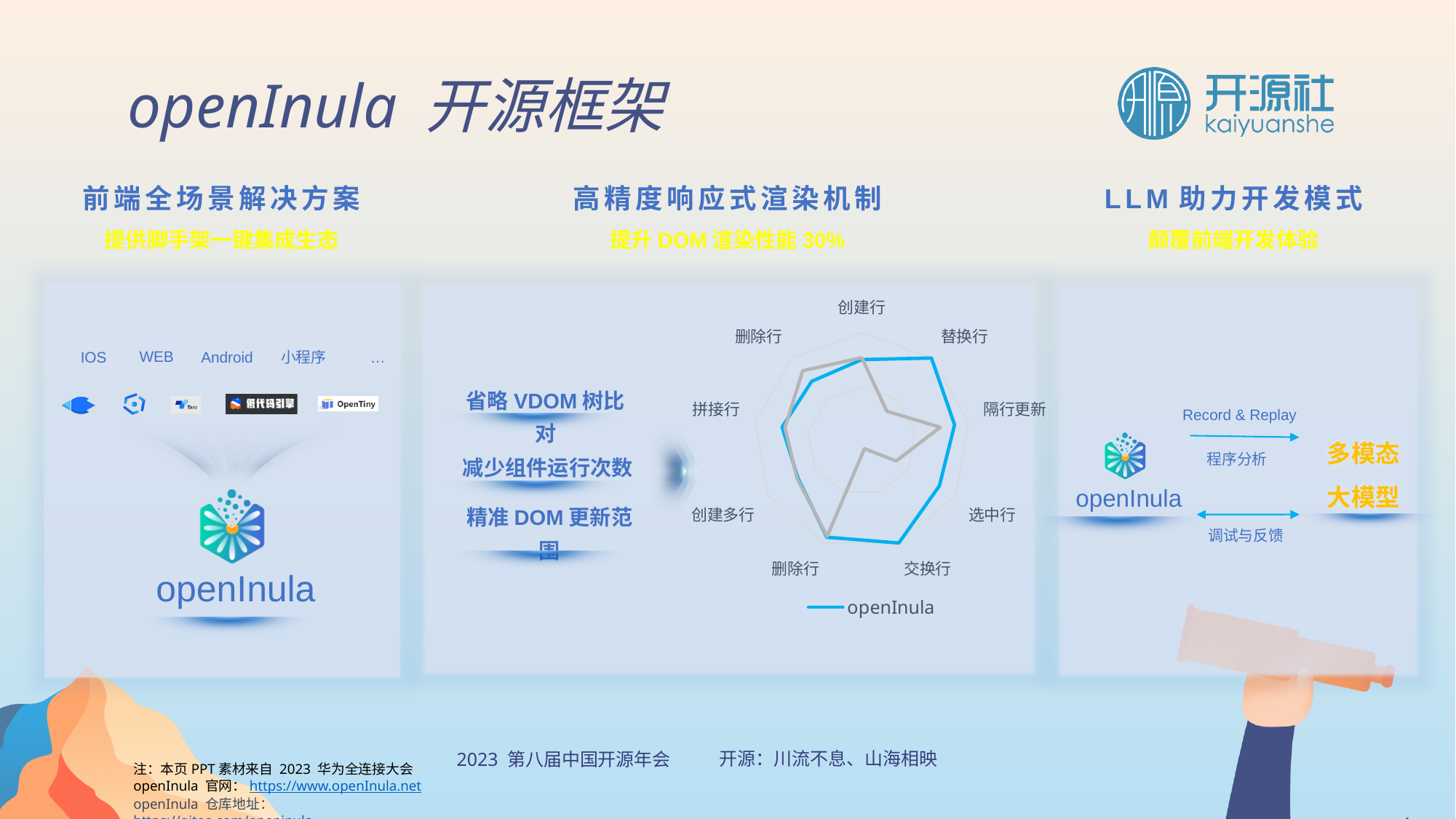
How many axes (categories) does the radar chart in the middle panel have? 9 What colour is the openInula series line in the radar chart? blue What kind of chart is shown in the middle panel under 高精度响应式渲染机制? radar chart How many series does the legend of the radar chart list? 1 Which category label appears at the top of the radar chart? 创建行 On the 替换行 axis of the radar chart, which line extends further from the centre, the blue openInula line or the grey line? openInula (blue) On the 选中行 axis of the radar chart, which line extends further from the centre, the blue openInula line or the grey line? openInula (blue) On the 交换行 axis of the radar chart, which line extends further from the centre, the blue openInula line or the grey line? openInula (blue) What is the name of the series shown in the legend of the radar chart? openInula